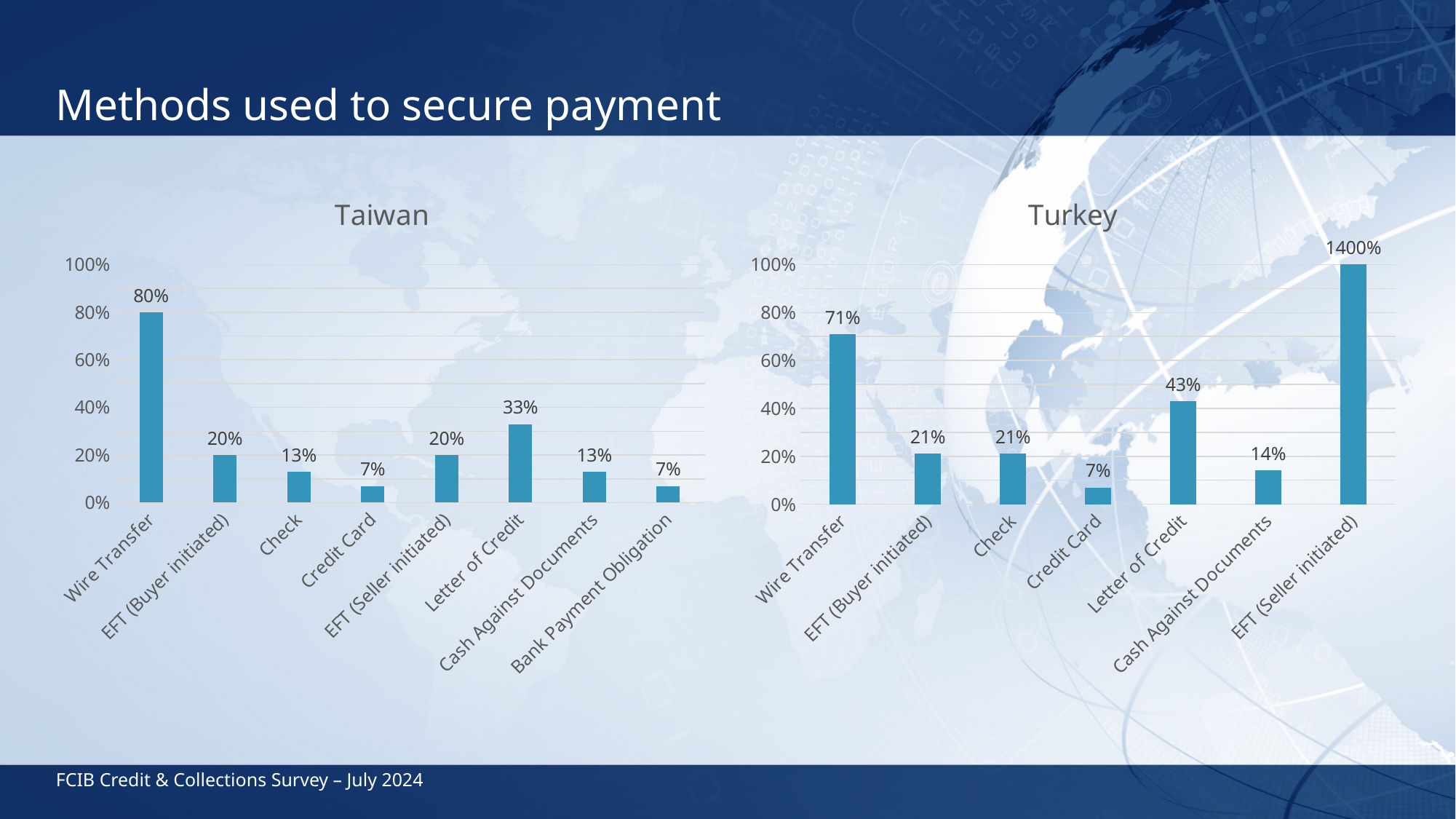
What kind of chart is the Taiwan chart? Bar chart In the Taiwan chart, what is the value for Wire Transfer? 80% In the Turkey chart, what is the difference between Wire Transfer and Letter of Credit? 28% In the Taiwan chart, which category has the highest value? Wire Transfer In the Taiwan chart, what is the difference between Wire Transfer and Letter of Credit? 47% How many categories are shown in the Turkey chart? 7 In the Taiwan chart, what is the value for Letter of Credit? 33% In the Turkey chart, which category has the lowest value? Credit Card How many categories are shown in the Taiwan chart? 8 In the Turkey chart, what is the value for Cash Against Documents? 14% In the Turkey chart, what is the value for Letter of Credit? 43% In the Taiwan chart, which is larger: Letter of Credit or EFT (Buyer initiated)? Letter of Credit